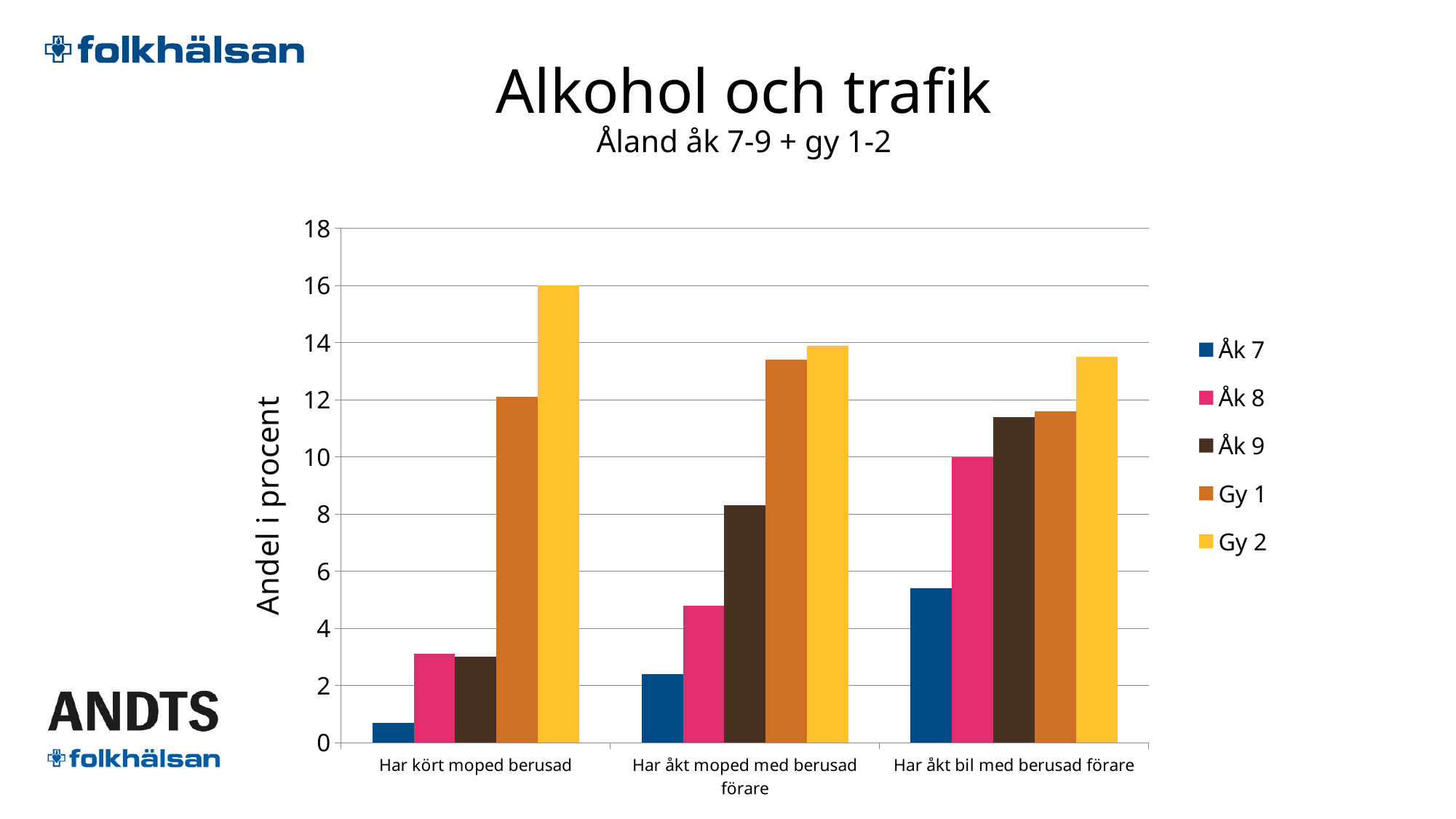
What is the label of the y axis? Andel i procent Is the value for Åk 7 in the category "Har kört moped berusad" greater or less than 2? less Do the values for Åk 7 rise or fall from left to right across the three categories? rise Which series has the highest value in the category "Har kört moped berusad"? Gy 2 In the category "Har åkt moped med berusad förare", which is larger, the value for Åk 8 or the value for Åk 9? Åk 9 What is the value for Gy 2 in the category "Har kört moped berusad"? 16 What is the value for Åk 8 in the category "Har åkt bil med berusad förare"? 10 Which series has the lowest value in the category "Har åkt bil med berusad förare"? Åk 7 How many series does the legend list? 5 Is the value for Åk 7 in the category "Har åkt bil med berusad förare" greater or less than 4? greater What kind of chart is shown on the slide? bar chart How many categories are shown on the x axis? 3